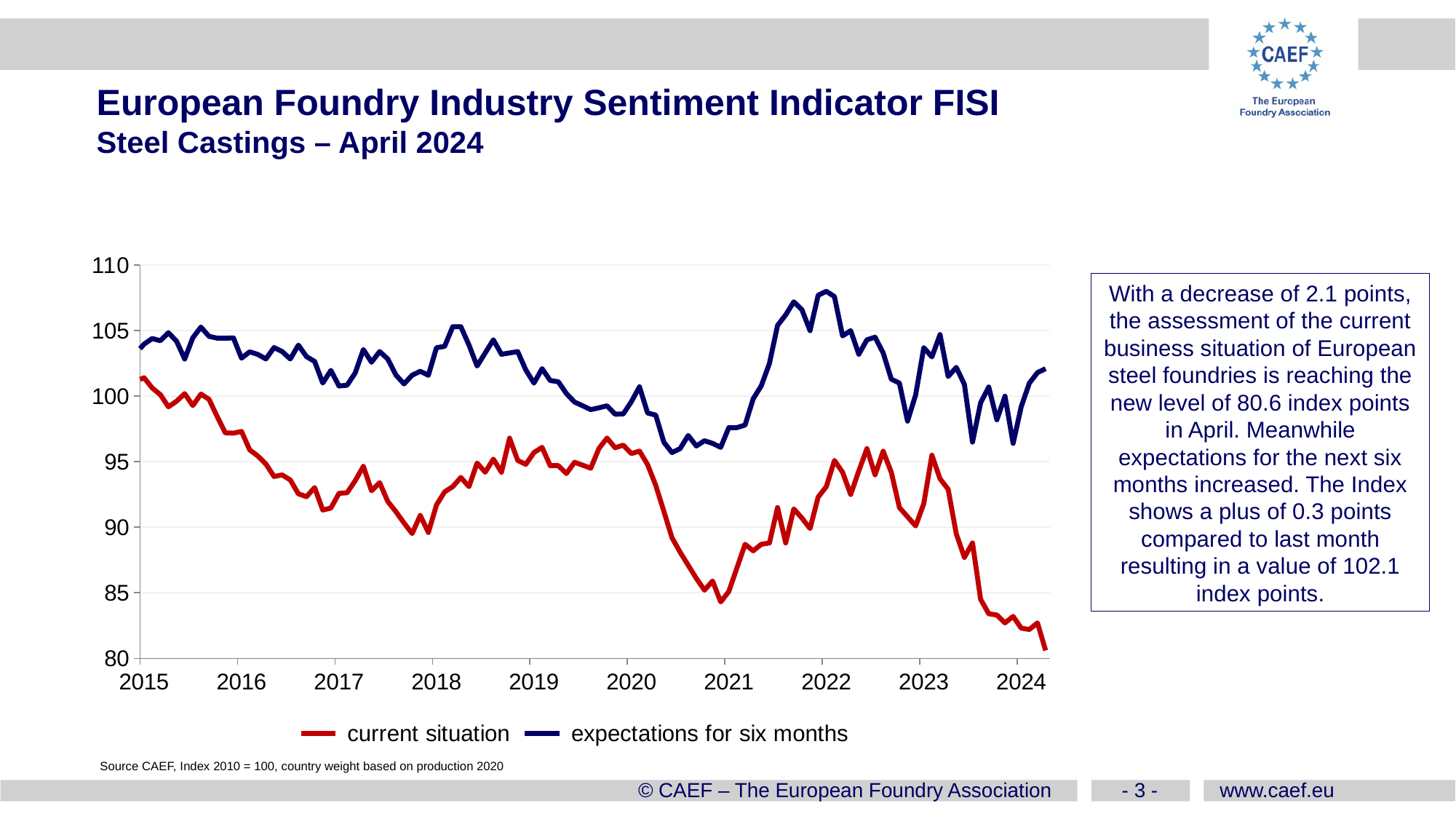
What are the two series named in the chart legend? current situation; expectations for six months What is the value of the current situation index for steel castings in April 2024? 80.6 Is the value of the current situation series at the start of 2015 greater or less than 95? greater What type of chart is shown on the slide? line chart How many series does the chart legend list? 2 What is the value of the expectations for six months index in April 2024? 102.1 At the end of the chart (April 2024), which series is higher: current situation or expectations for six months? expectations for six months Is the peak of the expectations for six months series in early 2022 greater or less than 105? greater By how many points did the current situation index decrease in April 2024? 2.1 Does the current situation series rise or fall between 2023 and 2024? fall Is the value of the current situation series at the end of 2020 greater or less than 90? less What is the difference between the expectations index (102.1) and the current situation index (80.6) in April 2024? 21.5